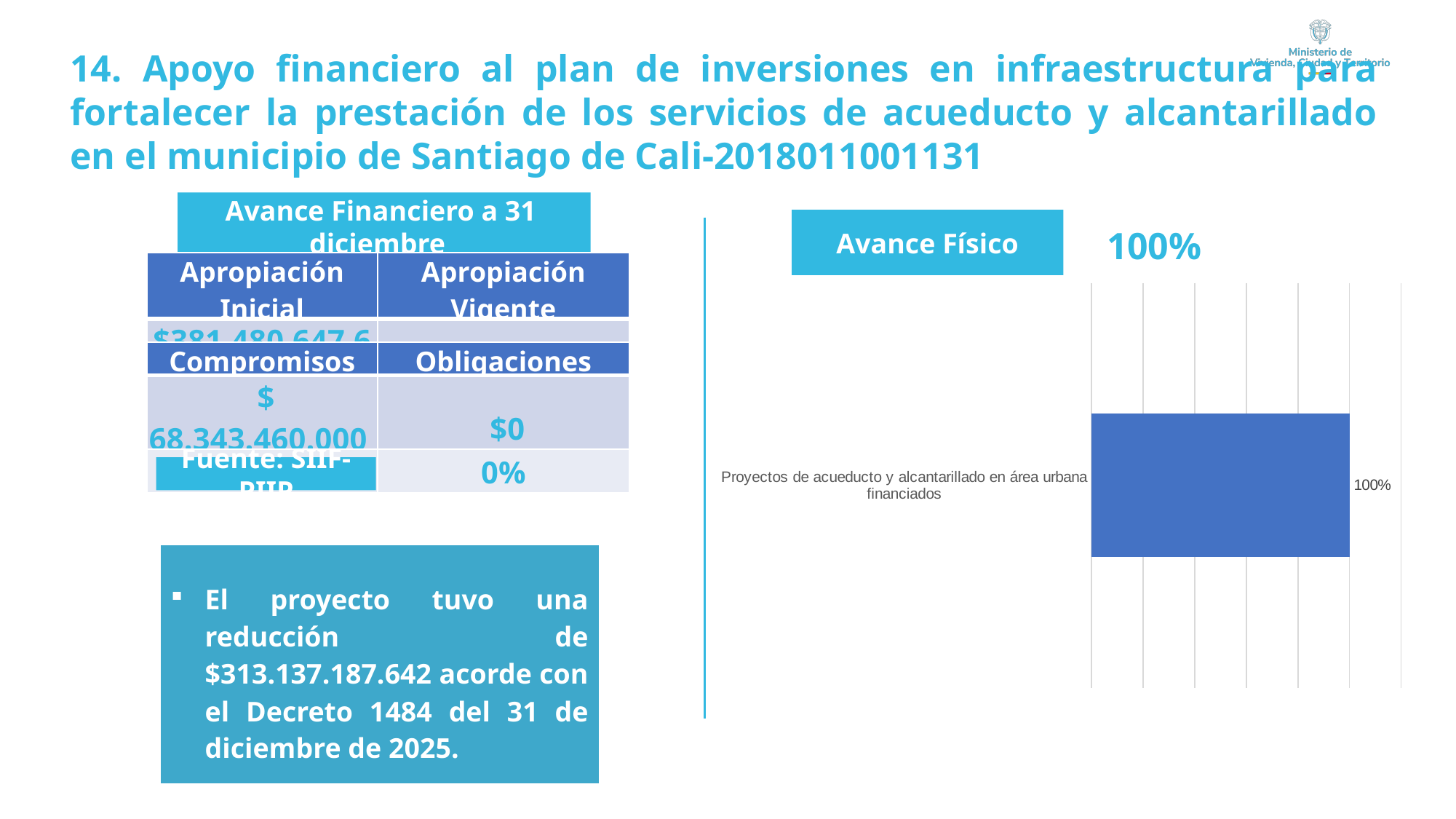
What kind of chart is used to show the Avance Físico? bar chart Are the bars in the Avance Físico chart horizontal or vertical? horizontal What is the value shown for "Proyectos de acueducto y alcantarillado en área urbana financiados" in the Avance Físico chart? 100% What is the label of the single category in the Avance Físico chart? Proyectos de acueducto y alcantarillado en área urbana financiados How many categories are plotted in the Avance Físico chart? 1 What data label is printed next to the bar in the Avance Físico chart? 100%